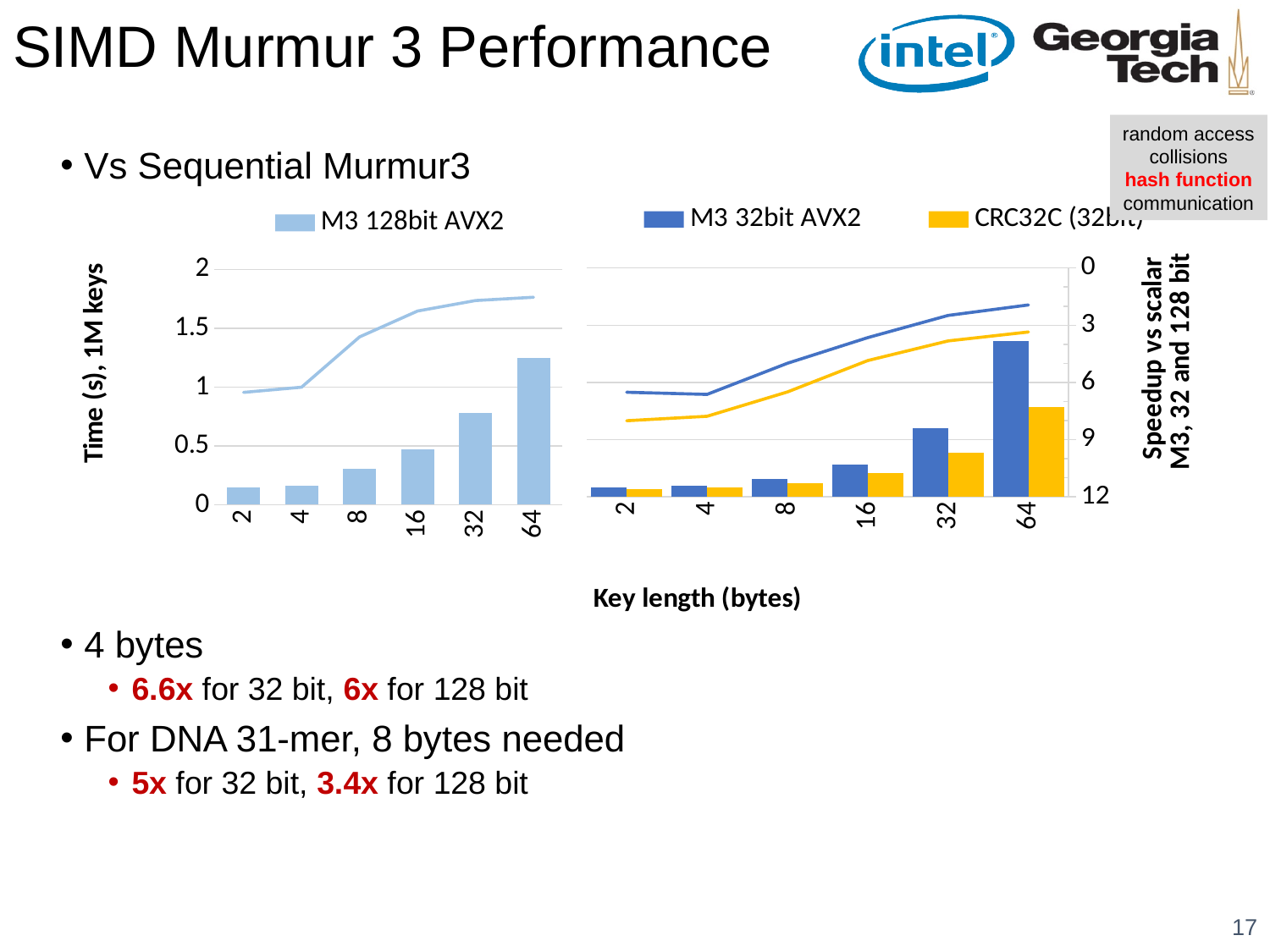
In the right panel, is the M3 32bit AVX2 bar for key length 64 greater or less than 1? greater In the left panel, is the M3 128bit AVX2 bar for key length 8 greater or less than 0.5? less How many series does the chart legend list? 3 In the left panel, which key length has the highest M3 128bit AVX2 bar? 64 What is the title of the x axis of the chart? Key length (bytes) In the left panel, is the M3 128bit AVX2 bar for key length 32 greater or less than 1? less Do the M3 32bit AVX2 bars rise or fall as key length increases along the x axis? rise In the right panel, which is larger at key length 64: the M3 32bit AVX2 bar or the CRC32C (32bit) bar? M3 32bit AVX2 How many key-length categories are shown on the x axis of the left panel (M3 128bit AVX2)? 6 What kind of chart is shown on the slide? bar chart (with line overlays)